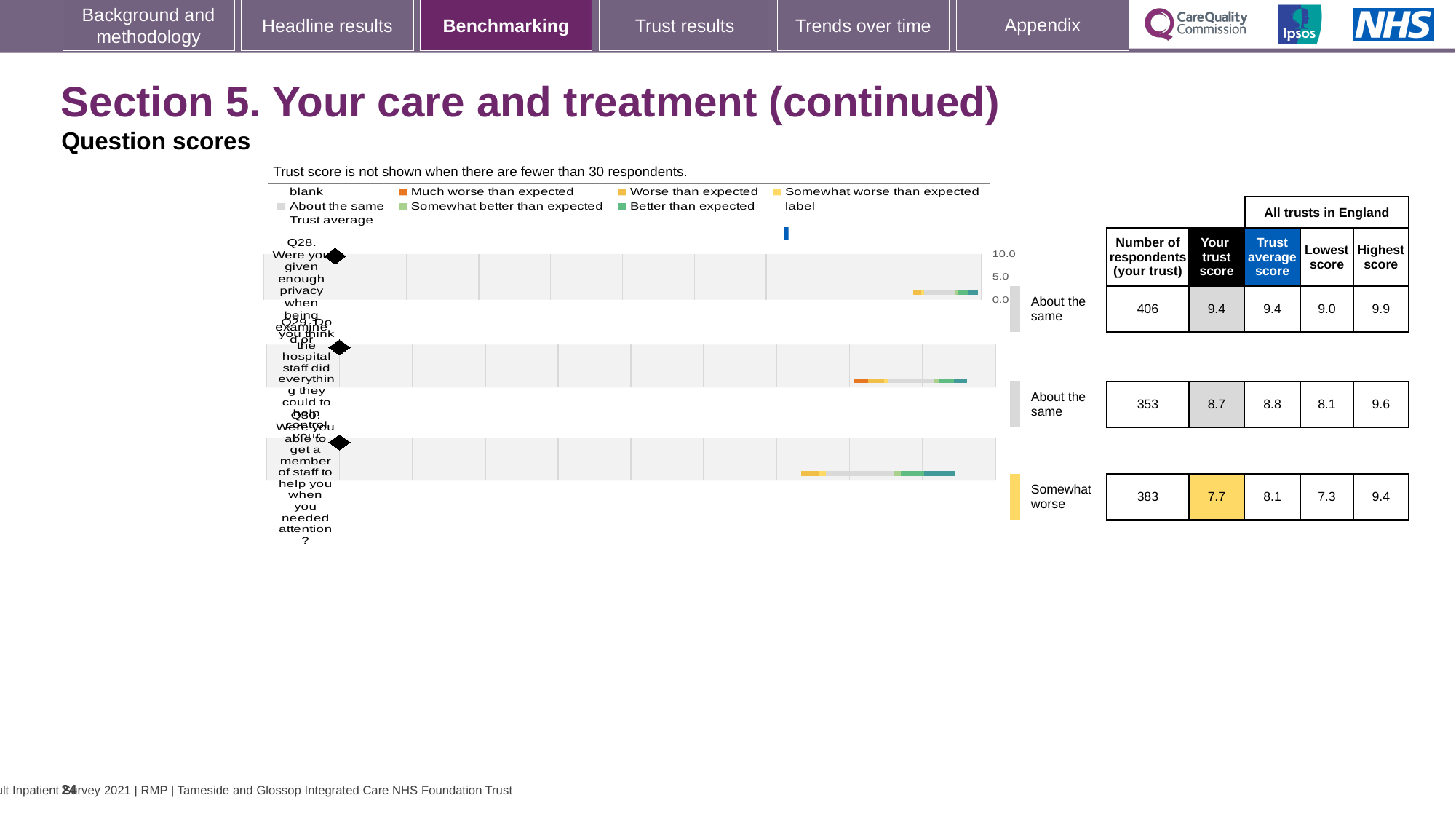
How many questions are plotted on the chart? 3 Which question is rated 'Somewhat worse' than expected? Q30 Which has the larger trust score, Q29 or Q30? Q29 What kind of chart is used to show the question scores? Bar chart What is the difference between the trust average score and the trust score for Q30? 0.4 What is the trust average score for Q29 (Do you think the hospital staff did everything they could to help control your pain?)? 8.8 What is the trust score for Q28 (Were you given enough privacy when being examined or treated?)? 9.4 Which question has the lowest trust score? Q30 What is the highest score across all trusts in England for Q28? 9.9 How many respondents answered Q29? 353 What is the trust score for Q30 (Were you able to get a member of staff to help you when you needed attention?)? 7.7 Which question has the highest trust score? Q28